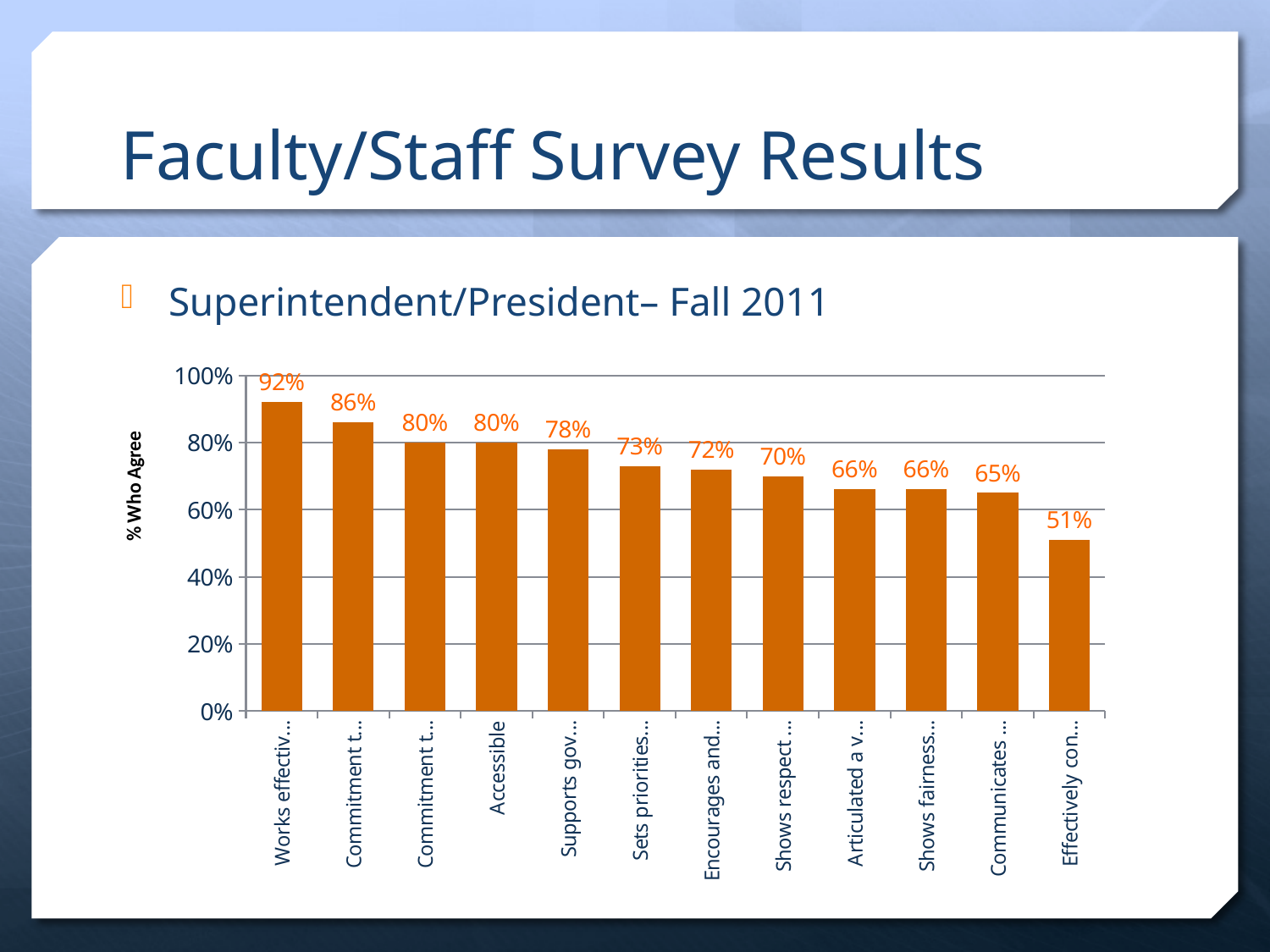
What is the value of the last (rightmost) bar, labelled "Effectively con..."? 51% What is the value for the bar labelled "Sets priorities..."? 73% What is the value for the "Accessible" category? 80% What is the label of the vertical axis? % Who Agree What is the difference between the highest bar (92%) and the lowest bar (51%)? 41% What is the value of the first (leftmost) bar, labelled "Works effectiv..."? 92% How many bars are shown in the chart? 12 Which bar has the highest value? Works effectiv... (the first bar), 92% What kind of chart is shown on the slide? Bar chart Do the bar values rise or fall from left to right along the x axis? Fall Which is larger: the value for "Accessible" or the value for "Shows respect ..."? Accessible Which bar has the lowest value? Effectively con... (the last bar), 51%